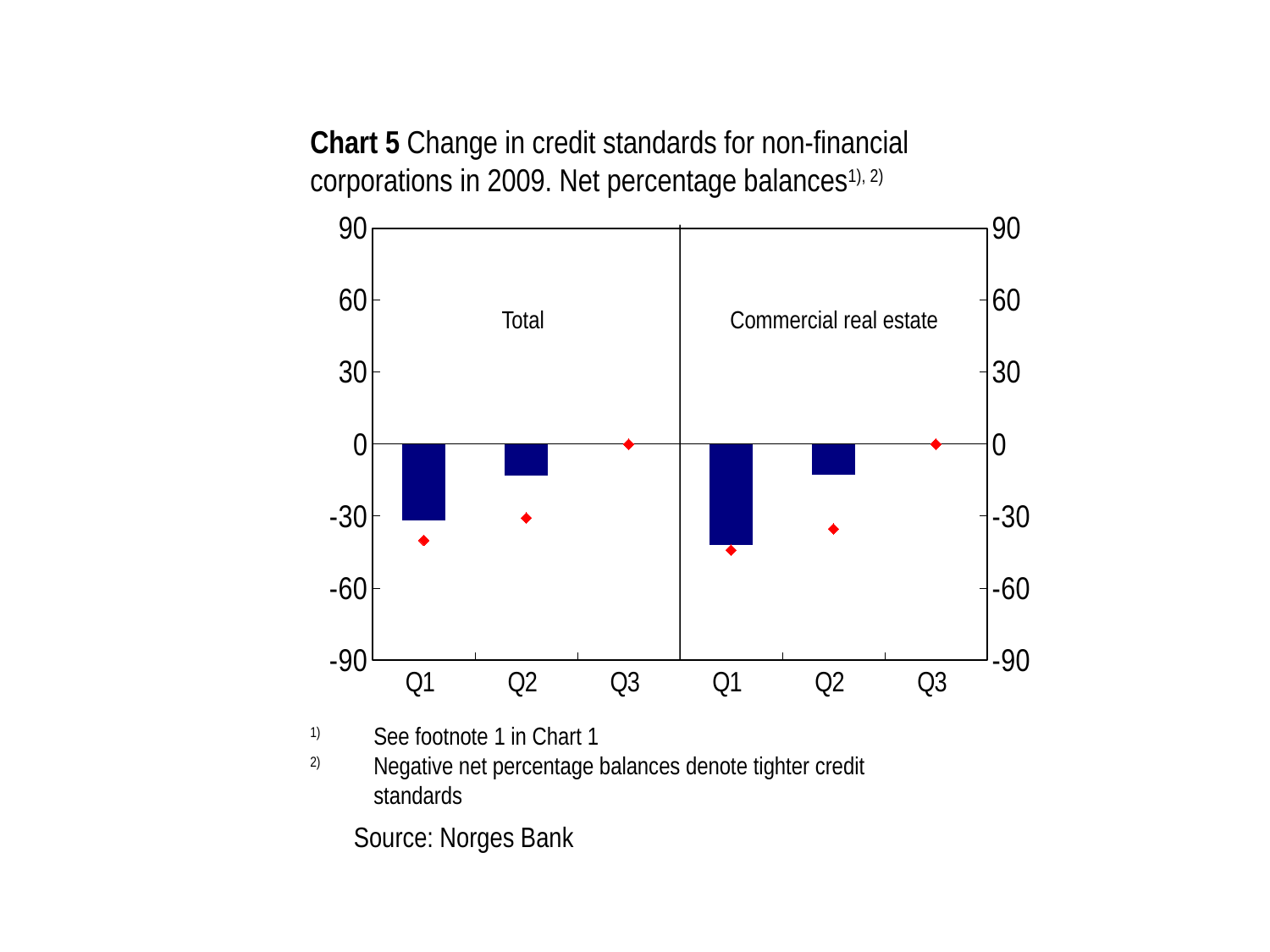
What are the two panels of the chart labelled? Total and Commercial real estate In the Commercial real estate panel, is the bar for Q1 greater or less than -30? less In the Commercial real estate panel, which quarter has the lowest bar? Q1 In the Total panel, is the bar for Q2 greater or less than -30? greater In the Commercial real estate panel, do the bars rise or fall from Q1 to Q3? rise In the Commercial real estate panel, is the bar for Q2 greater or less than -30? greater What kind of chart is shown on the slide? bar chart What is the source given for the chart? Norges Bank How many quarters are shown in the Total panel? 3